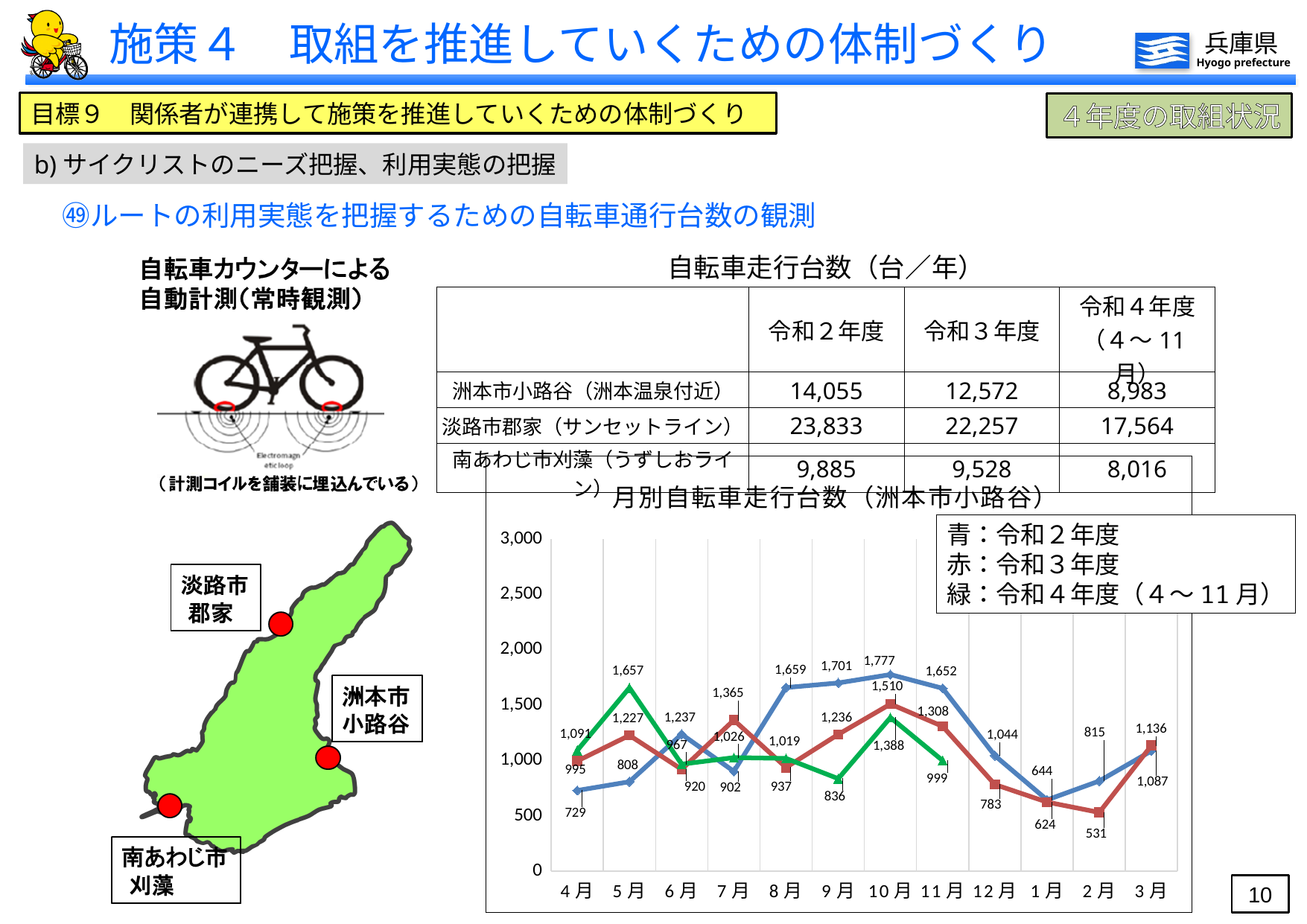
In the 月別自転車走行台数（洲本市小路谷） chart, which month has the lowest value for the red (令和3年度) series? 2月 In the 月別自転車走行台数（洲本市小路谷） chart, is the blue (令和2年度) value in 4月 greater or less than 1,000? less In the 月別自転車走行台数（洲本市小路谷） chart, what is the value of the green (令和4年度) series in 5月? 1,657 How many series does the legend of the 月別自転車走行台数（洲本市小路谷） chart list? 3 In the 月別自転車走行台数（洲本市小路谷） chart, which month has the highest value for the blue (令和2年度) series? 10月 In the 月別自転車走行台数（洲本市小路谷） chart, does the blue (令和2年度) series rise or fall from 8月 to 10月? rise In the 月別自転車走行台数（洲本市小路谷） chart, which series has the larger value in 5月, the green (令和4年度) or the blue (令和2年度)? green (令和4年度) How many months are plotted along the x axis of the 月別自転車走行台数（洲本市小路谷） chart? 12 What kind of chart is the 月別自転車走行台数（洲本市小路谷） chart? line chart In the 月別自転車走行台数（洲本市小路谷） chart, what is the value of the red (令和3年度) series in 2月? 531 In the 月別自転車走行台数（洲本市小路谷） chart, what is the value of the blue (令和2年度) series in 10月? 1,777 In the 月別自転車走行台数（洲本市小路谷） chart, what is the difference between the blue (令和2年度) and red (令和3年度) values in 10月? 267